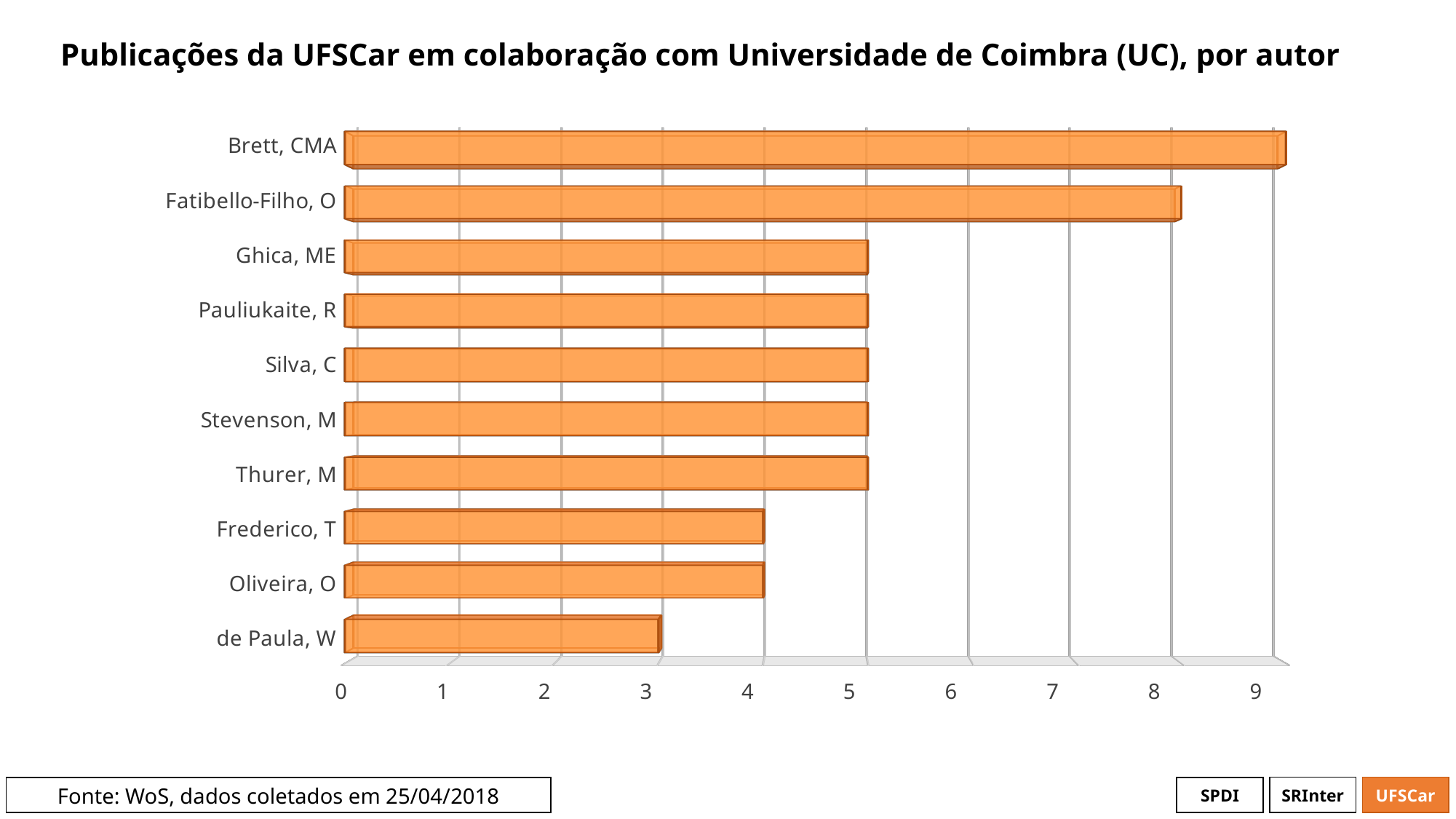
How many publications does Fatibello-Filho, O have according to the chart? 8 How many publications does de Paula, W have according to the chart? 3 How many authors are listed in the chart? 10 Who has more publications, Fatibello-Filho, O or Thurer, M? Fatibello-Filho, O What is the source of the data cited on the slide? WoS, dados coletados em 25/04/2018 Who has more publications, Frederico, T or de Paula, W? Frederico, T What kind of chart is shown on the slide? bar chart Is the value for Oliveira, O greater or less than 5? less Which author has the highest number of publications in collaboration with Universidade de Coimbra? Brett, CMA How many publications does Brett, CMA have according to the chart? 9 Is the value for Ghica, ME greater or less than 4? greater Which author has the lowest number of publications in the chart? de Paula, W